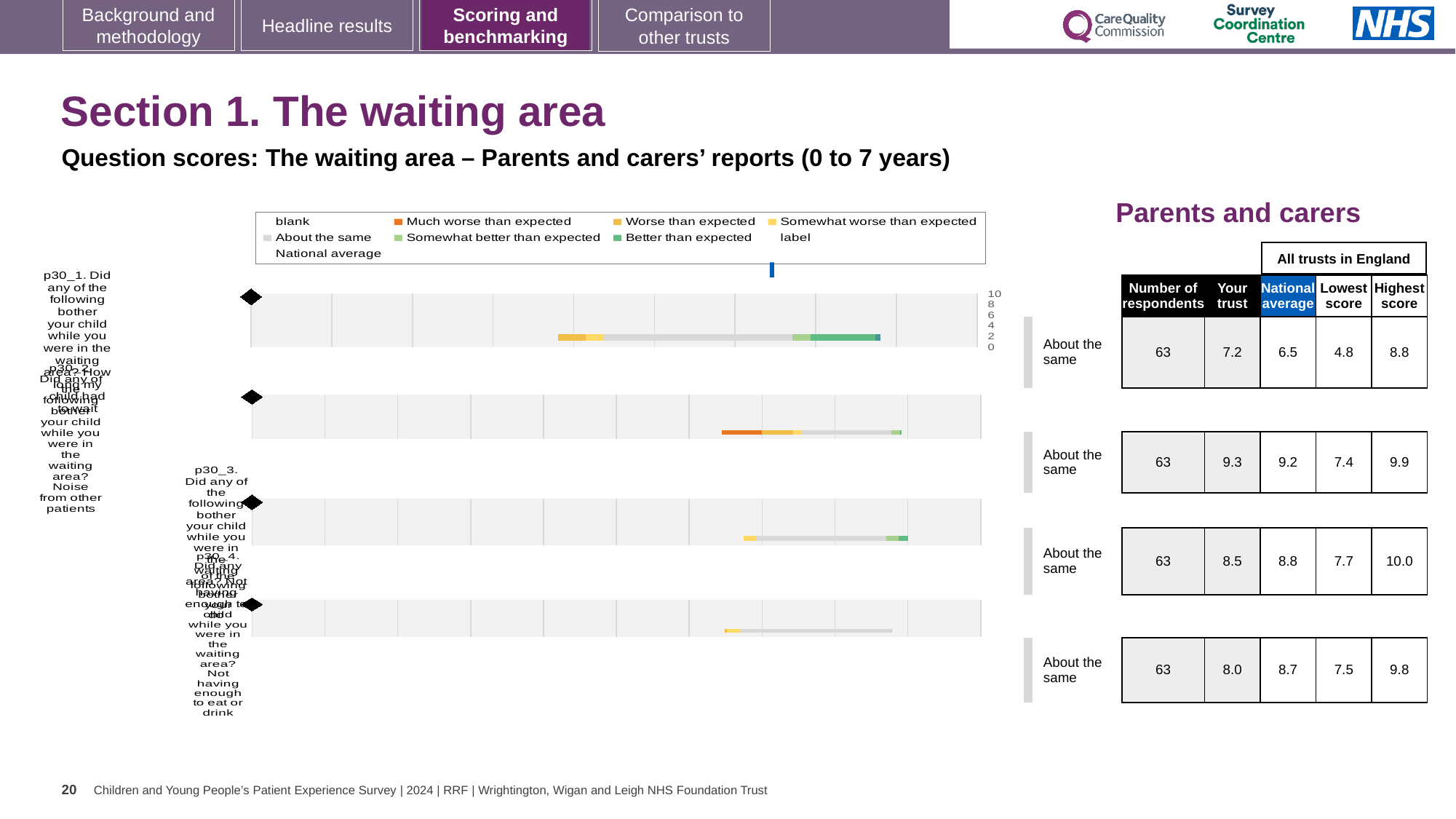
In the table beside the chart, is the 'Your trust' score for the fourth row larger or smaller than its national average? smaller In the table beside the chart, what is the 'Your trust' score for the first row? 7.2 In the table beside the chart, how many respondents are listed for each row? 63 What kind of chart is shown on the slide? bar chart In the table beside the chart, what is the difference between the highest score and the lowest score in the first row? 4.0 What is the highest tick value shown on the chart's axis? 10 In the table beside the chart, which row has the highest 'Your trust' score? the second row (9.3) In the table beside the chart, what is the highest score for the third row? 10.0 Which colour does the legend use for 'Much worse than expected'? orange How many horizontal bars (questions) are plotted in the chart? 4 What benchmark label is shown next to each bar in the chart? About the same In the table beside the chart, what is the national average for the first row? 6.5